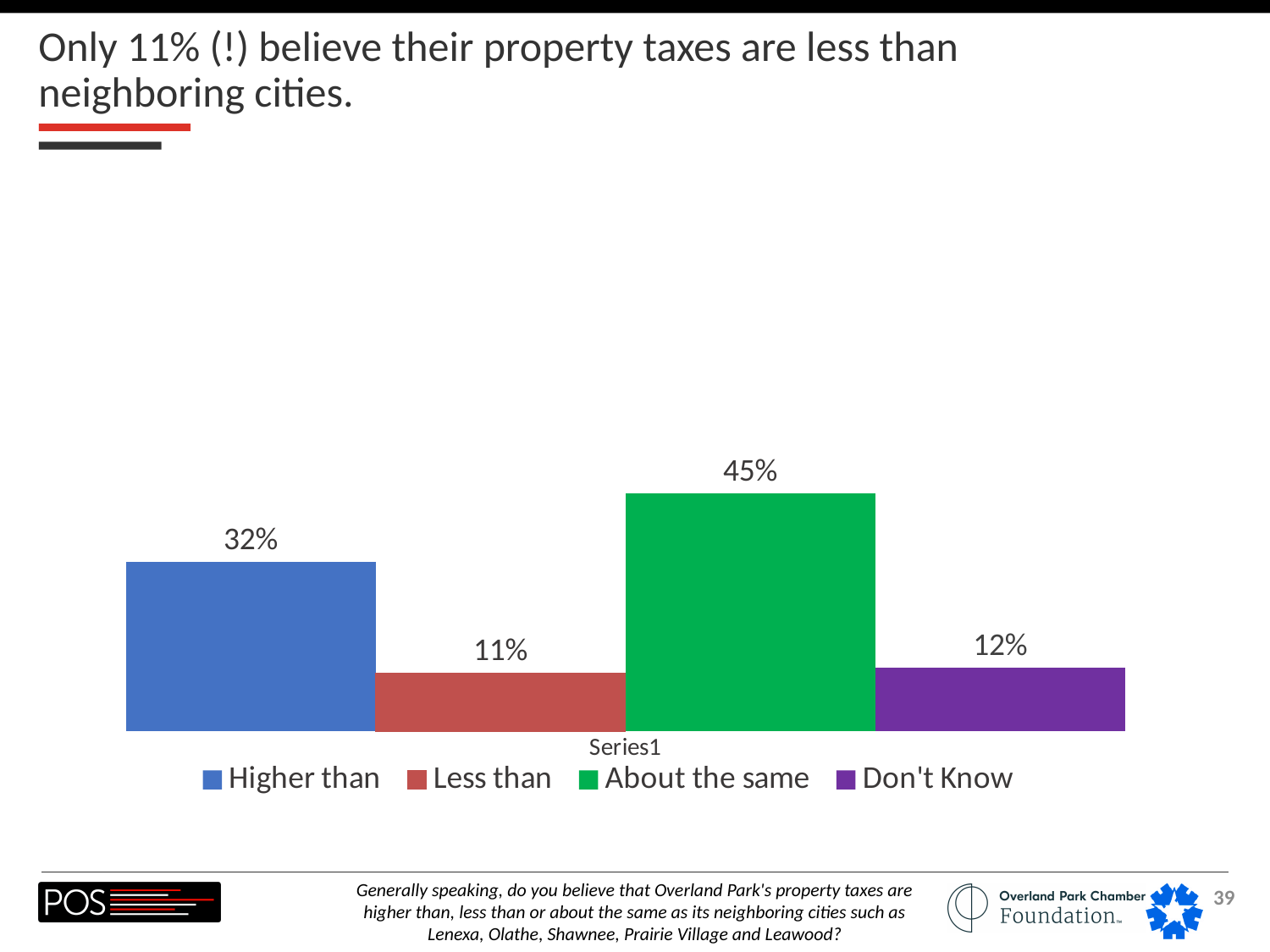
What percentage of respondents answered Don't Know? 12% What percentage of respondents believe Overland Park's property taxes are less than neighboring cities? 11% What is the difference between the 'About the same' and 'Higher than' percentages? 13% What percentage of respondents believe Overland Park's property taxes are higher than neighboring cities? 32% Which response has the lowest percentage? Less than Which is larger, the percentage for 'Higher than' or for 'Don't Know'? Higher than What is the difference between the 'Don't Know' and 'Less than' percentages? 1% What kind of chart is shown on the slide? Bar chart What colour is the bar for 'About the same'? Green How many response categories are shown in the chart? 4 What percentage of respondents believe Overland Park's property taxes are about the same as neighboring cities? 45% Which response has the highest percentage? About the same